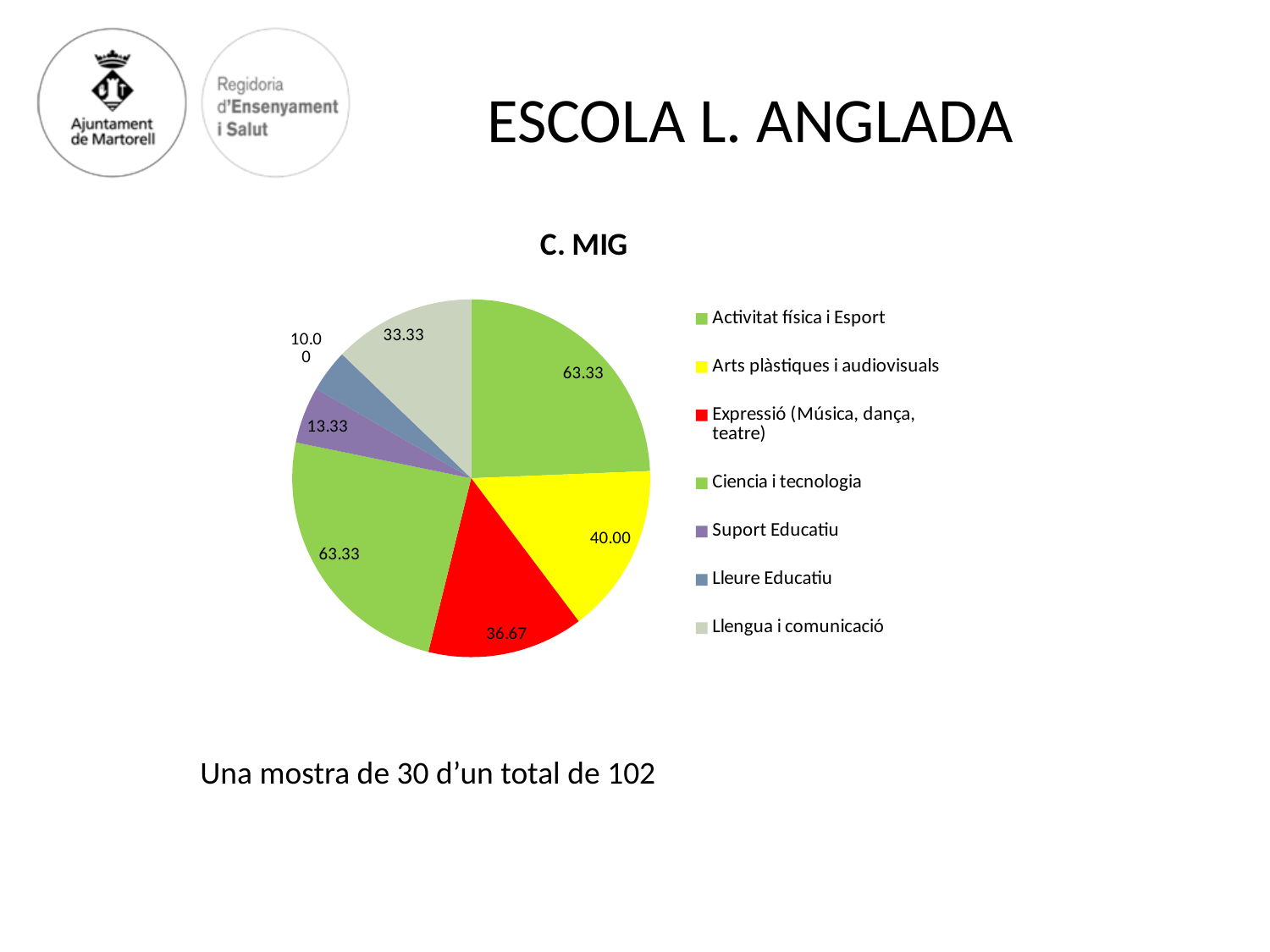
What is the difference between the values for Arts plàstiques i audiovisuals and Expressió (Música, dança, teatre)? 3.33 Which category has the smallest slice in the pie chart? Lleure Educatiu What is the value shown for Llengua i comunicació? 33.33 What colour is the slice for Expressió (Música, dança, teatre)? Red What is the value shown for Activitat física i Esport? 63.33 What is the title of the chart? C. MIG What is the value shown for Arts plàstiques i audiovisuals? 40.00 What is the value shown for Suport Educatiu? 13.33 How many slices does the pie chart have? 7 What is the value shown for Expressió (Música, dança, teatre)? 36.67 Which is larger, the value for Llengua i comunicació or the value for Suport Educatiu? Llengua i comunicació What type of chart is shown on the slide? Pie chart